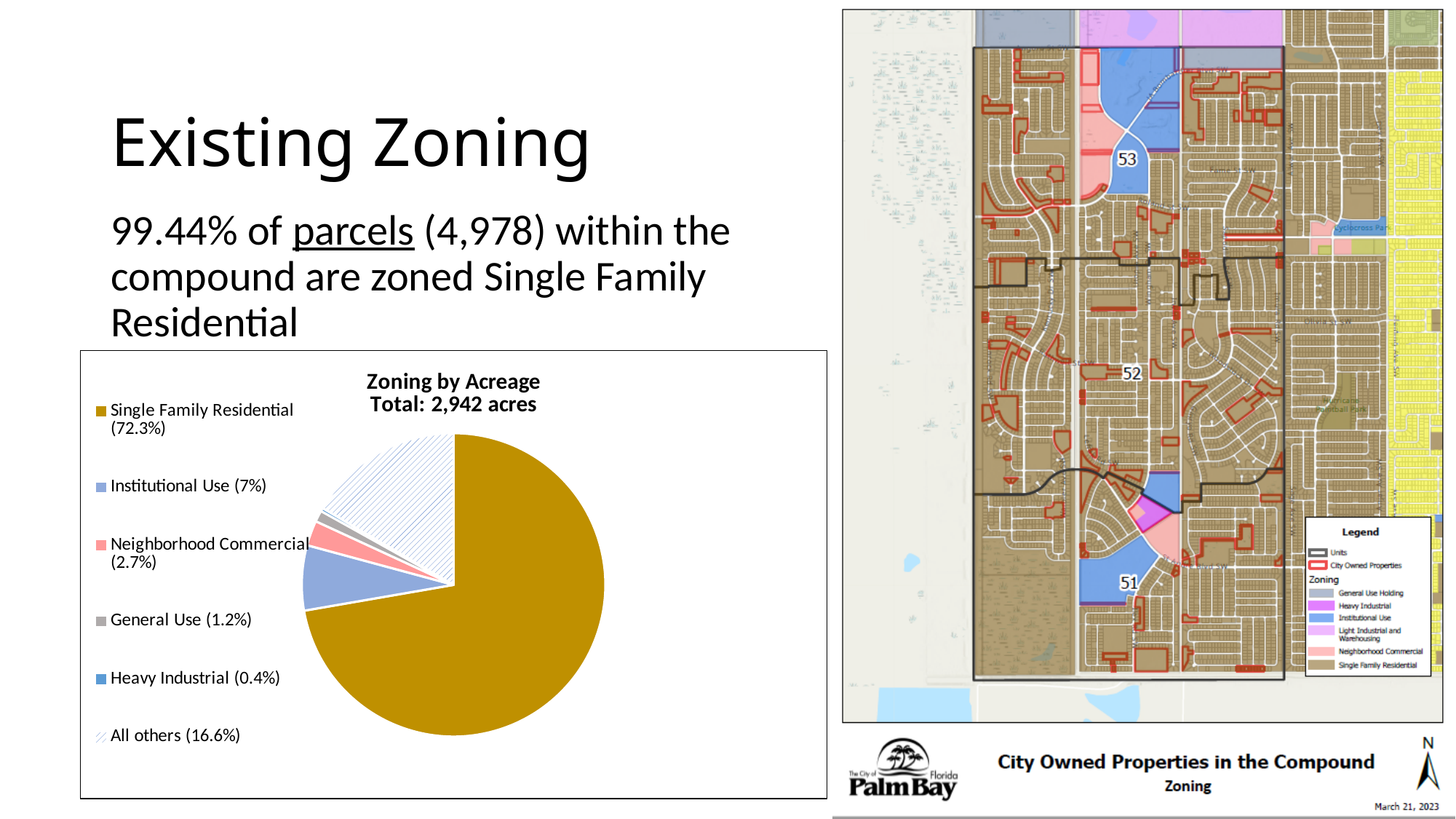
What share of the pie does Institutional Use represent? 7% What total acreage is stated in the pie chart's title? 2,942 acres How many slices does the pie chart have? 6 What share of the pie does Heavy Industrial represent? 0.4% Which zoning category has the largest slice of the pie? Single Family Residential What share of the pie does Single Family Residential represent? 72.3% What is the difference in percentage points between Institutional Use and General Use in the pie chart? 5.8 What type of chart is the "Zoning by Acreage" chart? pie chart Which is larger in the pie chart, General Use or Neighborhood Commercial? Neighborhood Commercial Which zoning category has the smallest slice of the pie? Heavy Industrial What is the title of the pie chart? Zoning by Acreage